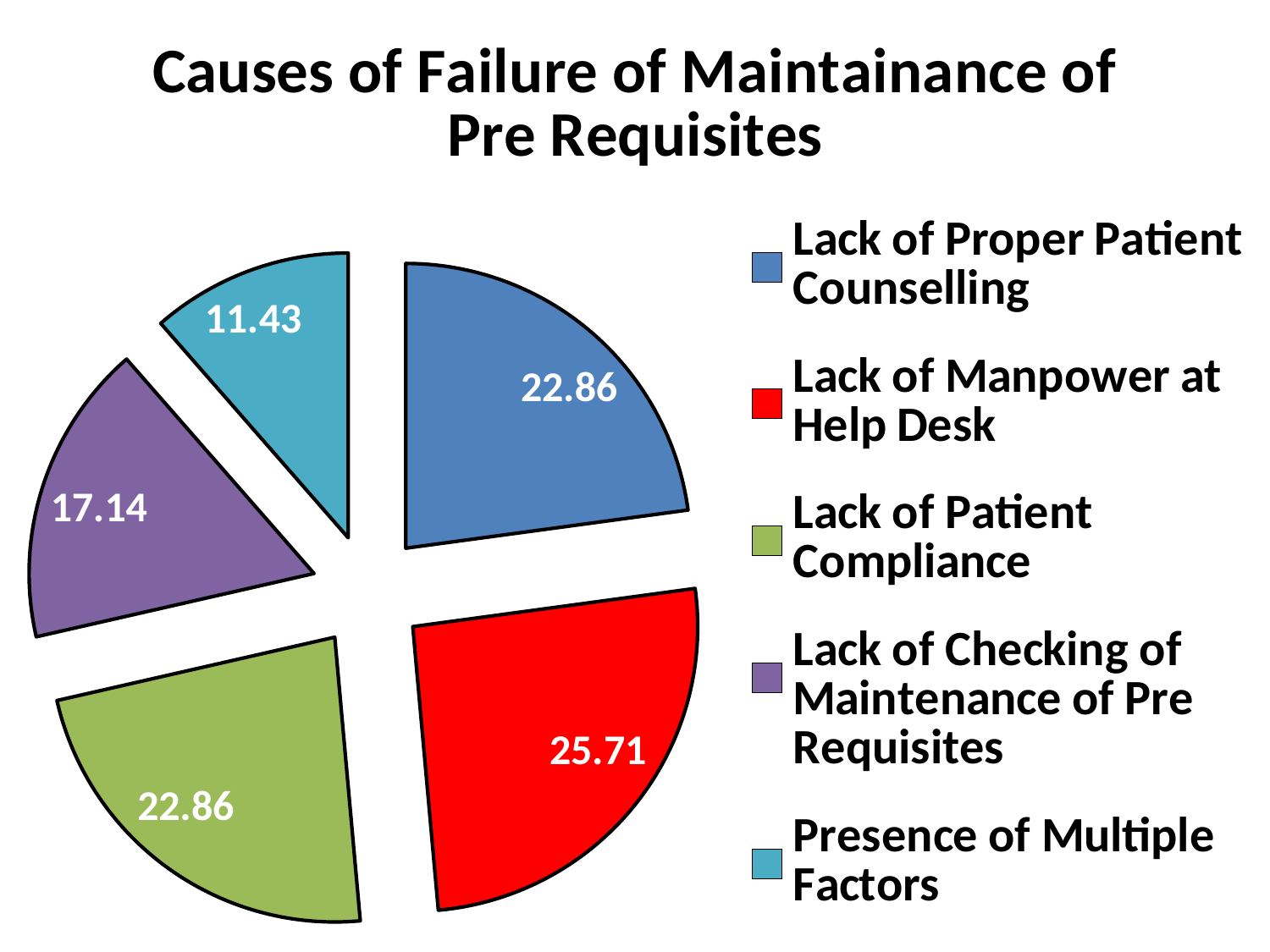
What is the value for Presence of Multiple Factors? 11.43 How many slices does the pie chart have? 5 What is the difference between the values for Lack of Manpower at Help Desk and Presence of Multiple Factors? 14.28 What is the value for Lack of Manpower at Help Desk? 25.71 Which category has the smallest slice? Presence of Multiple Factors What is the title of the chart? Causes of Failure of Maintainance of Pre Requisites What is the value for Lack of Checking of Maintenance of Pre Requisites? 17.14 Which is larger: Lack of Patient Compliance or Lack of Checking of Maintenance of Pre Requisites? Lack of Patient Compliance What is the value for Lack of Proper Patient Counselling? 22.86 Which category has the largest slice? Lack of Manpower at Help Desk What colour is the slice for Lack of Manpower at Help Desk? Red What type of chart is shown on the slide? Pie chart